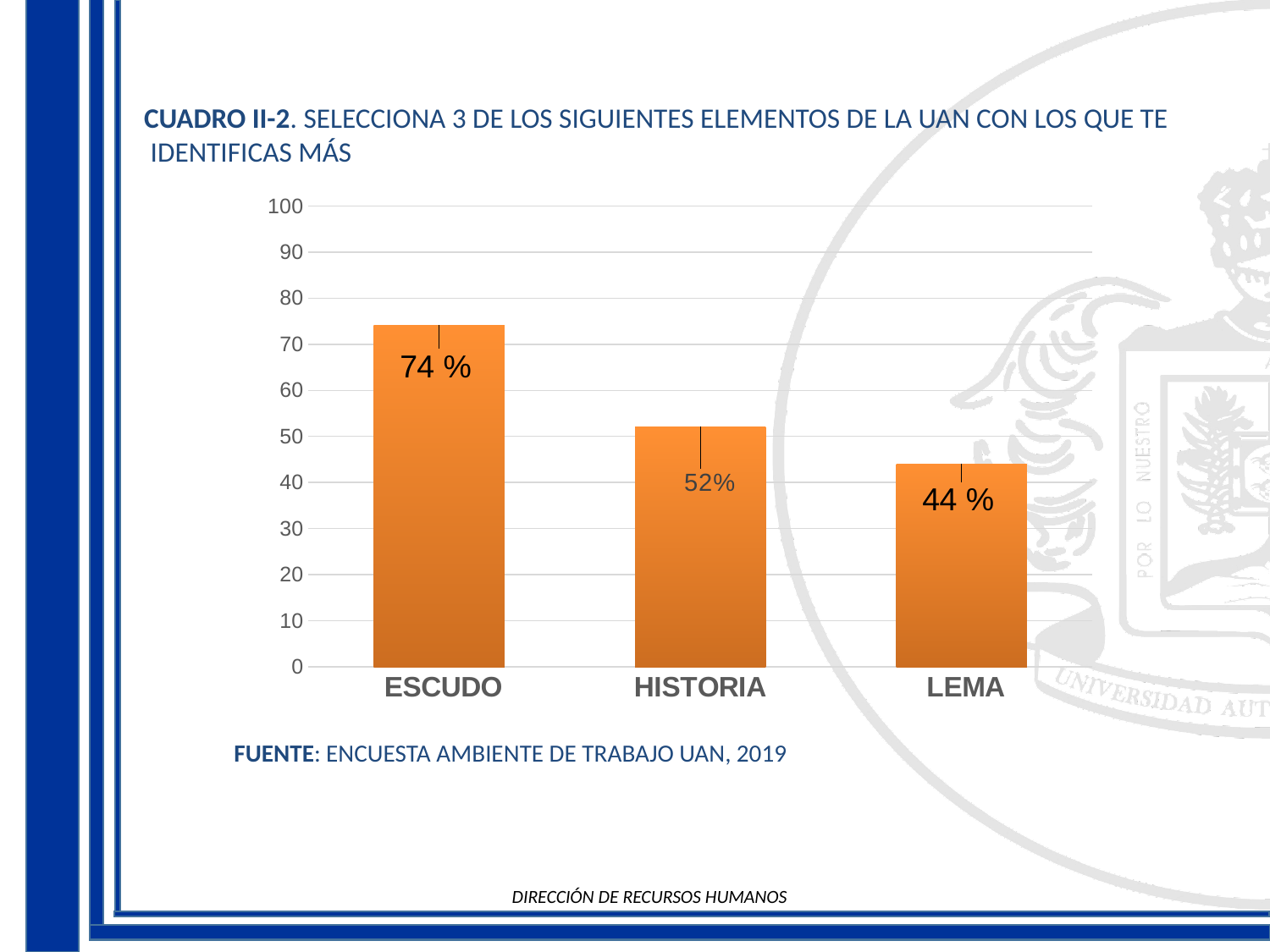
What is the value for LEMA? 44 % What is the difference between the values for ESCUDO and LEMA? 30 What is the value for HISTORIA? 52% Which category has the highest value? ESCUDO Which category has the lowest value? LEMA What is the difference between the values for HISTORIA and LEMA? 8 How many categories are shown on the chart? 3 What kind of chart is shown on the slide? bar chart Is the value for ESCUDO greater or less than 70? greater Which is larger, the value for HISTORIA or the value for LEMA? HISTORIA What is the value for ESCUDO? 74 % Do the values rise or fall from left to right across the categories? fall